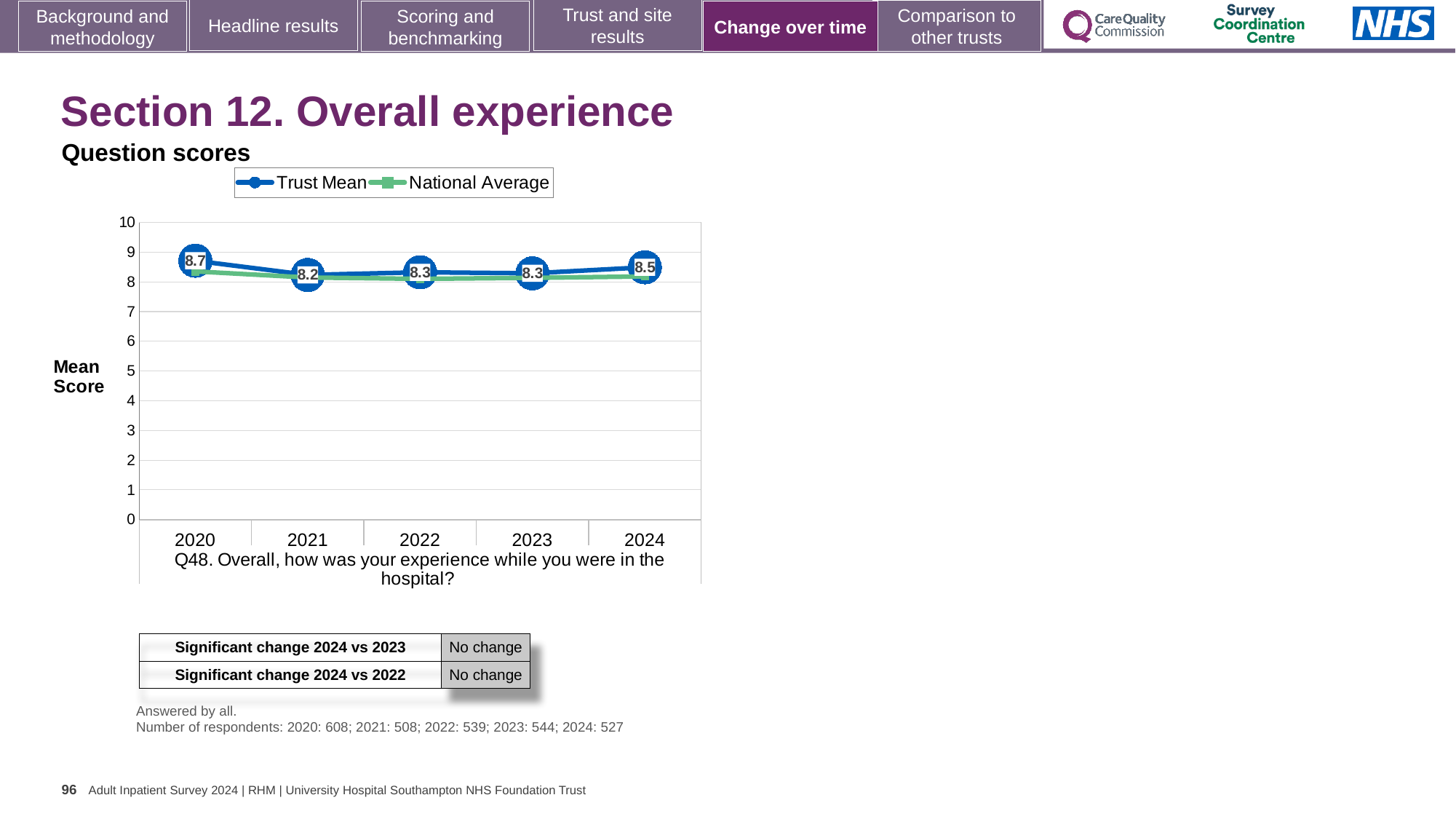
What is the difference between the Trust Mean score in 2020 and in 2021? 0.5 What kind of chart is shown? line chart In which year is the Trust Mean score lowest? 2021 Which is larger, the Trust Mean score in 2024 or in 2023? 2024 Is the National Average value for 2020 greater or less than 9? less What is the Trust Mean score for 2021? 8.2 What is the Trust Mean score for 2024? 8.5 How many series does the legend list? 2 What is the label of the y axis? Mean Score What is the Trust Mean score for 2020? 8.7 In which year is the Trust Mean score highest? 2020 How many years are plotted on the x axis? 5